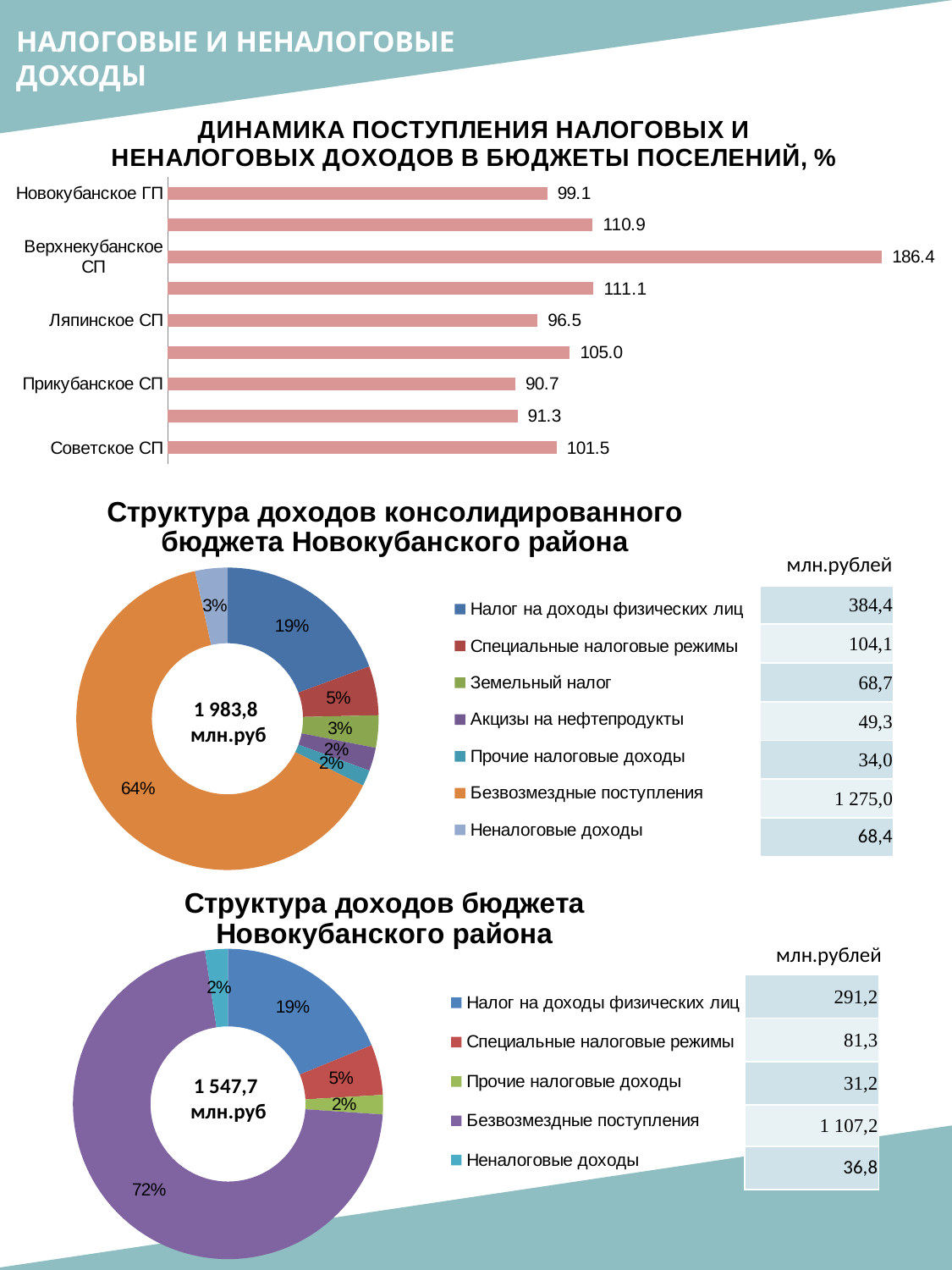
In the top bar chart 'Динамика поступления налоговых и неналоговых доходов в бюджеты поселений, %', what is the value for Новокубанское ГП? 99.1 What type of chart is the top chart on the slide? Bar chart What total is shown in the centre of the doughnut chart 'Структура доходов бюджета Новокубанского района'? 1 547,7 млн.руб In the top bar chart, which is larger: the value for Советское СП or the value for Ляпинское СП? Советское СП In the doughnut chart 'Структура доходов консолидированного бюджета Новокубанского района', what share does Безвозмездные поступления have? 64% How many categories does the legend of the chart 'Структура доходов консолидированного бюджета Новокубанского района' list? 7 In the top bar chart, which labeled settlement has the highest value? Верхнекубанское СП In the top bar chart, what is the difference between the values for Верхнекубанское СП and Ляпинское СП? 89.9 In the doughnut chart 'Структура доходов бюджета Новокубанского района', what is the value in млн.рублей for Безвозмездные поступления? 1 107,2 In the top bar chart, which labeled settlement has the lowest value? Прикубанское СП In the top bar chart, how many bars are plotted? 9 In the doughnut chart 'Структура доходов консолидированного бюджета Новокубанского района', what is the value in млн.рублей for Налог на доходы физических лиц? 384,4